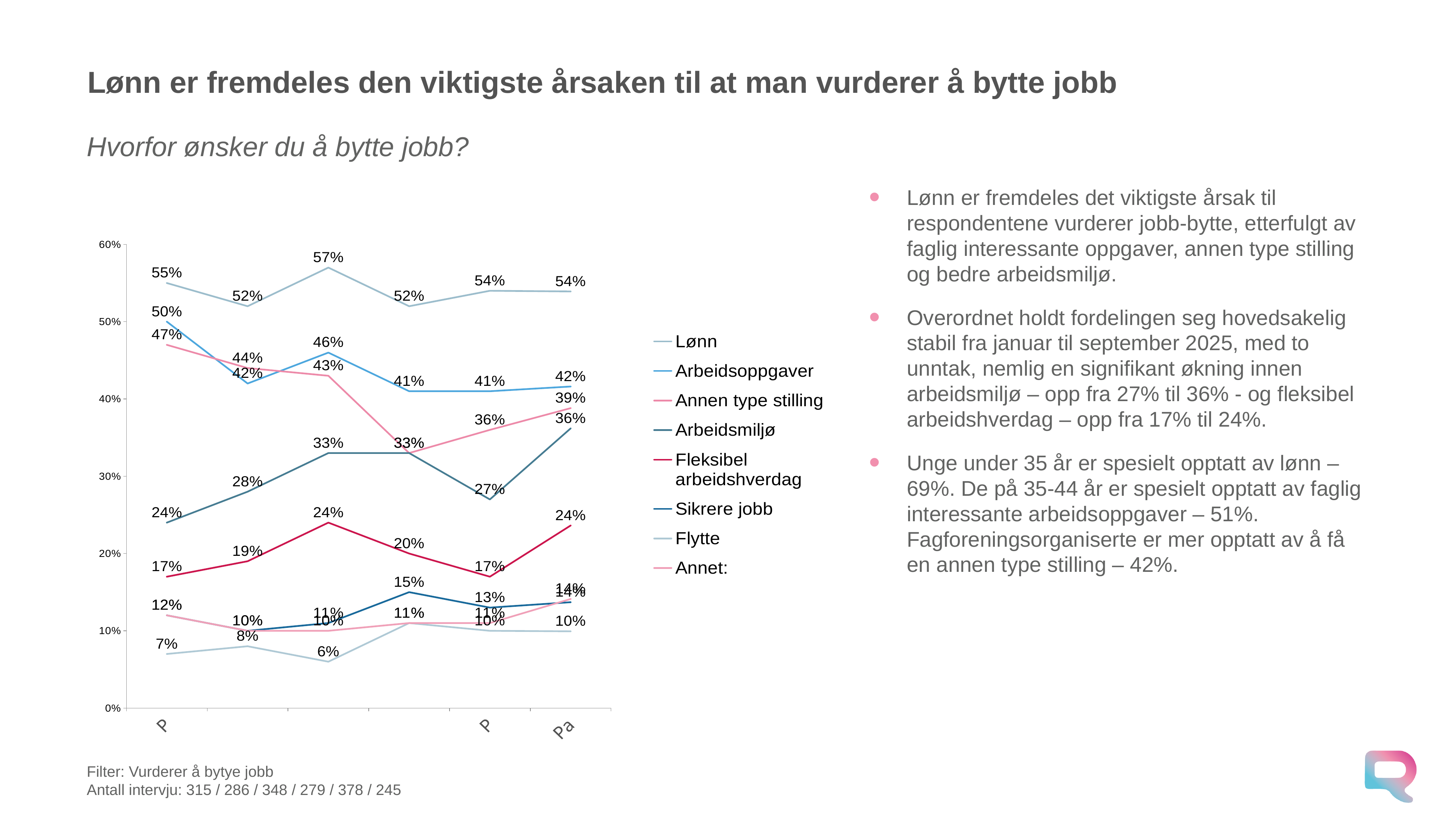
What is the highest value reached by the Lønn line? 57% What is the difference between the highest Lønn value (57%) and the highest Arbeidsoppgaver value (50%)? 7 percentage points Does the Arbeidsmiljø line end higher or lower than it starts? higher What is the title of the slide? Lønn er fremdeles den viktigste årsaken til at man vurderer å bytte jobb How many series does the legend list? 8 How many data points does each line in the chart have? 6 Which series has the highest values across the whole chart? Lønn What is the value of the Annen type stilling line at its leftmost point? 47% What kind of chart is shown on the slide? line chart What is the lowest value reached by the Flytte line? 6% What is the highest value reached by the Fleksibel arbeidshverdag line? 24% What is the value of the Arbeidsmiljø line at its rightmost point? 36%